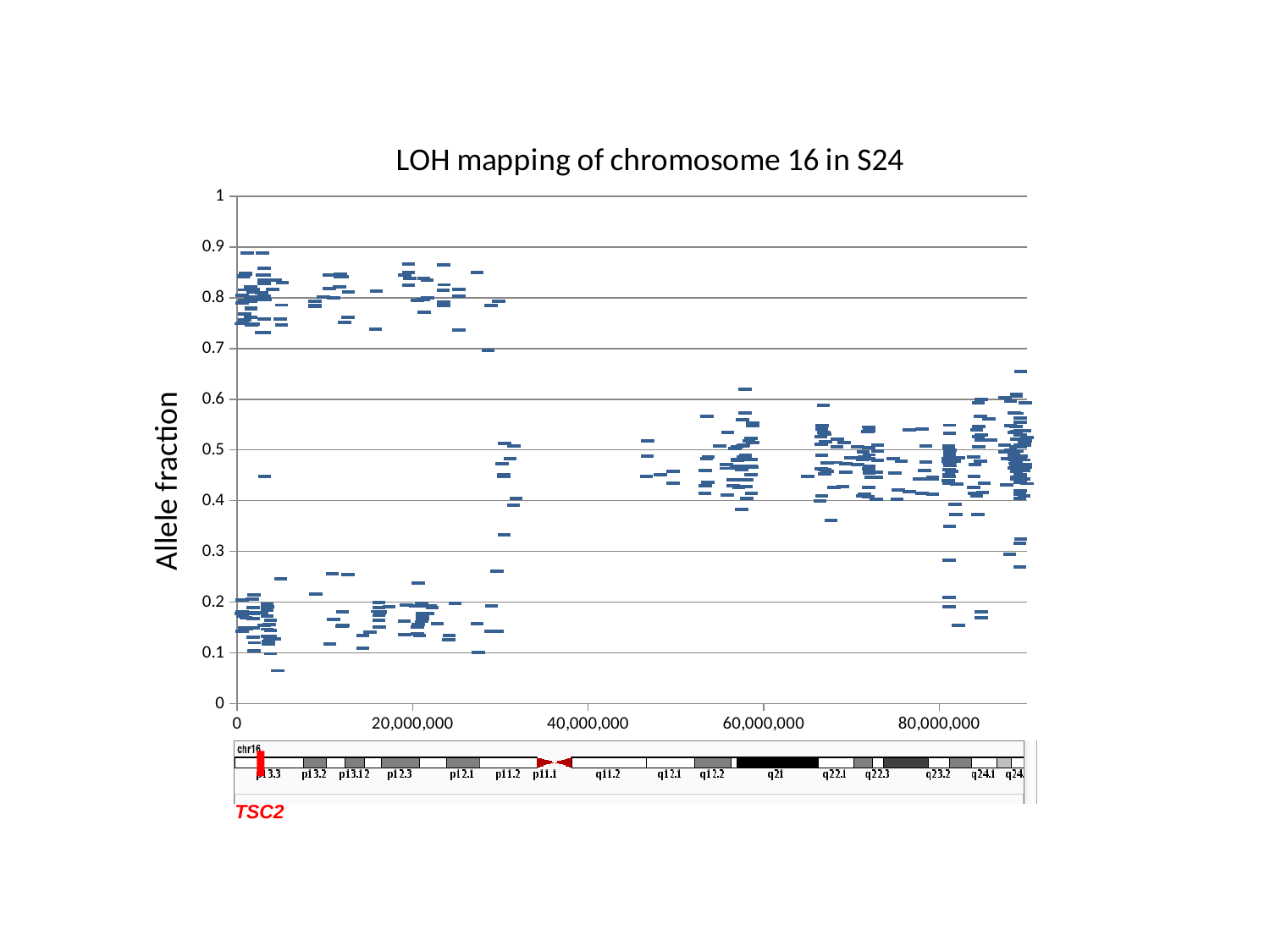
Is the lowest plotted point on the chart greater or less than 0.1? less What is the title of the chart? LOH mapping of chromosome 16 in S24 Are the points plotted beyond 60,000,000 on the horizontal axis mostly greater or less than 0.7? less What is the label on the vertical axis of the chart? Allele fraction What is the highest value shown on the vertical axis? 1 What is the largest tick label shown on the horizontal axis? 80,000,000 What is the spacing between consecutive tick labels on the vertical axis? 0.1 Are any points plotted between 35,000,000 and 45,000,000 on the horizontal axis? No Do the points plotted between 0 and 30,000,000 form one cluster or two separate clusters of allele fraction values? two separate clusters What kind of chart is shown on the slide? scatter chart Is the highest plotted point on the chart greater or less than 0.9? less